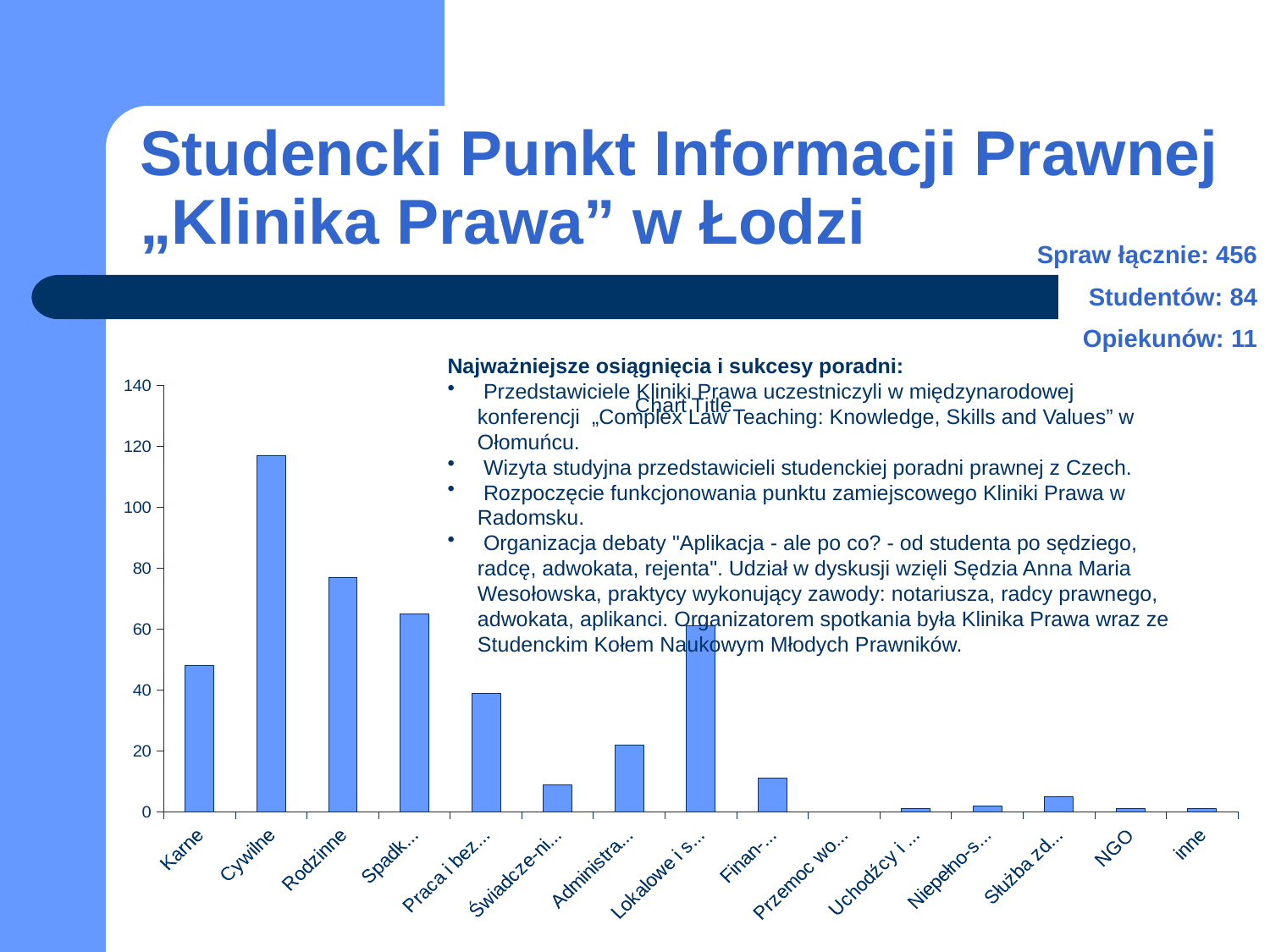
Which category has the highest bar in the chart? Cywilne Is the value for Cywilne greater or less than 100? greater What kind of chart is shown on the slide? bar chart Is the value for Praca i bez... greater or less than 20? greater Is the value for Administra... greater or less than 40? less Which is larger, the value for Cywilne or the value for Rodzinne? Cywilne What is the title shown above the chart? Chart Title Which is larger, the value for Karne or the value for Praca i bez...? Karne How many categories are plotted on the x axis of the chart? 15